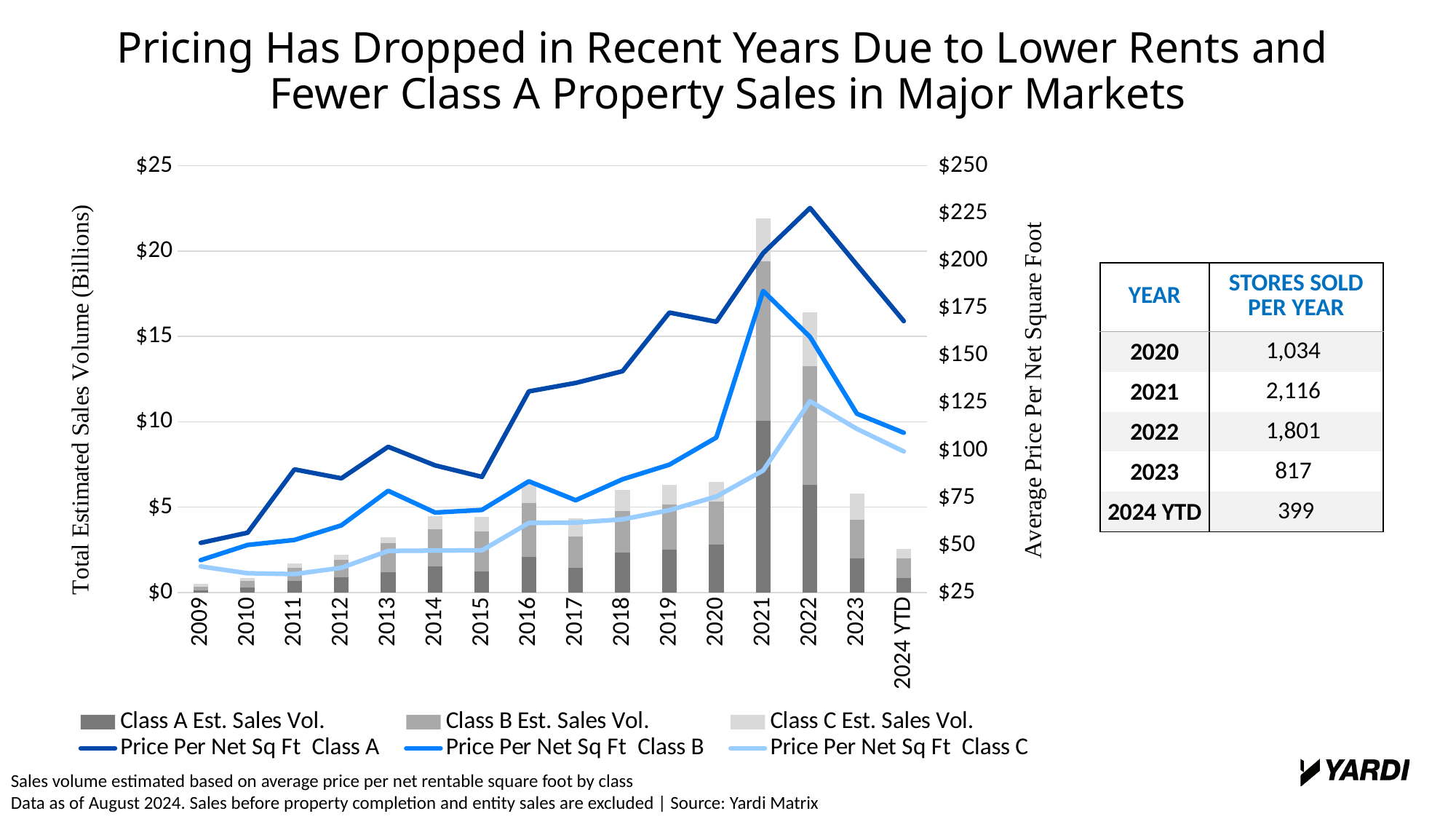
Is the total estimated sales volume for 2021 greater or less than $20 billion? greater How many years (categories) are shown along the x axis of the chart? 16 Which year has the tallest total estimated sales volume bar? 2021 Is the total estimated sales volume for 2024 YTD greater or less than $5 billion? less What is the title of the right-hand vertical axis of the chart? Average Price Per Net Square Foot How many series does the chart legend list? 6 In 2021, which is higher: Price Per Net Sq Ft Class A or Price Per Net Sq Ft Class B? Price Per Net Sq Ft Class A Does the Price Per Net Sq Ft Class A line rise or fall from 2022 to 2024 YTD? fall What kind of chart is shown on the slide? A combination bar and line chart (stacked bars with lines) Is the Price Per Net Sq Ft Class A value for 2022 greater or less than $200? greater Which year has the lowest total estimated sales volume bar? 2009 In which year does the Price Per Net Sq Ft Class A line reach its peak? 2022